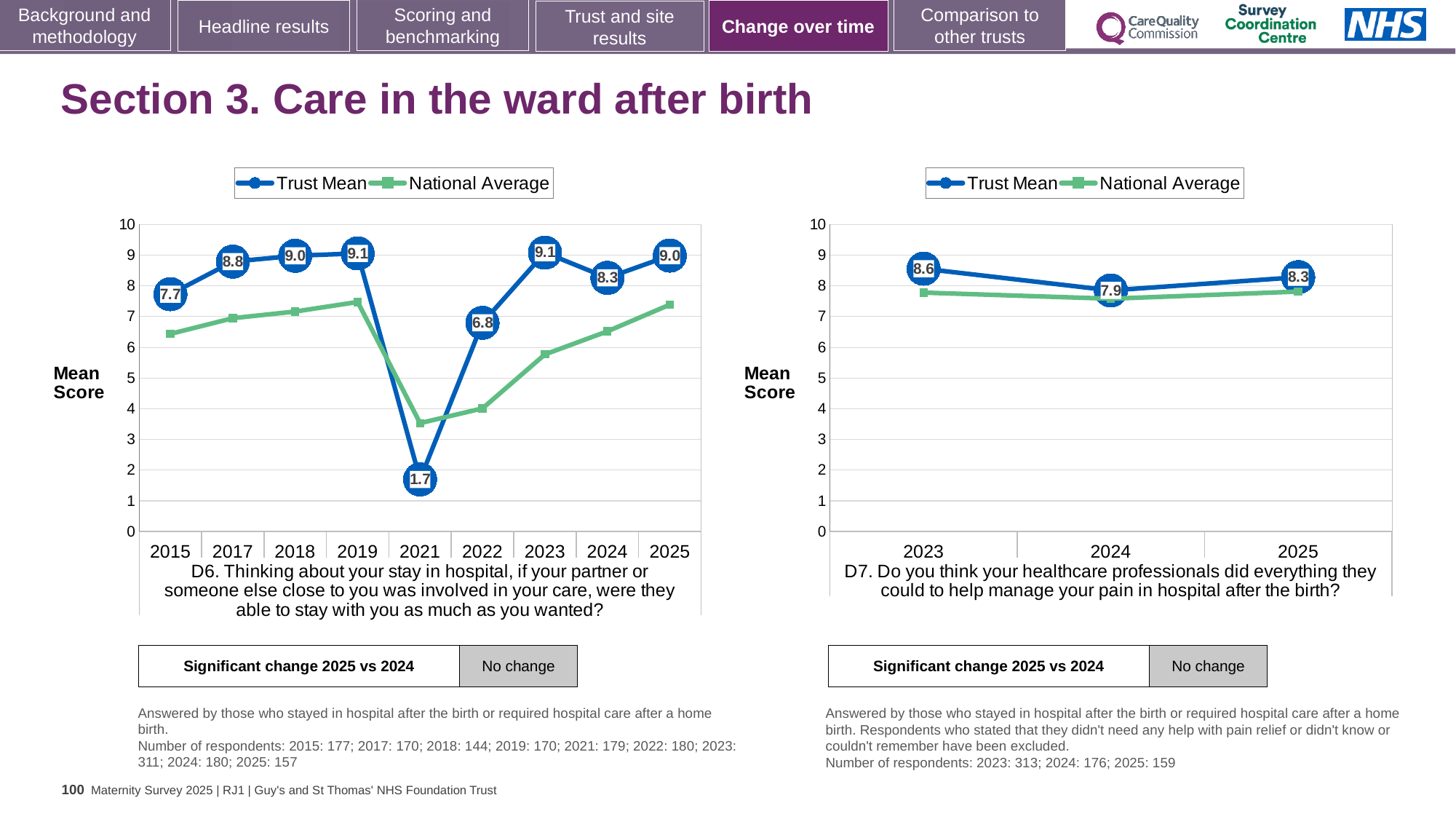
In the D7 chart on the right, which year has the highest Trust Mean score? 2023 In the D7 chart on the right, what is the difference between the Trust Mean scores for 2023 and 2025? 0.3 In the D6 chart on the left, what is the Trust Mean score for 2021? 1.7 In the D7 chart on the right, what is the Trust Mean score for 2024? 7.9 In the D6 chart on the left, is the National Average value for 2021 greater or less than 4? less In the D7 chart on the right, does the Trust Mean rise or fall from 2023 to 2024? fall How many years are plotted on the x axis of the D7 chart on the right? 3 In the D6 chart on the left, which is larger, the Trust Mean for 2015 or the Trust Mean for 2024? 2024 In the D6 chart on the left, what is the Trust Mean score for 2025? 9.0 How many series does the legend of the D6 chart on the left list? 2 In the D6 chart on the left, what is the difference between the Trust Mean scores for 2022 and 2021? 5.1 In the D6 chart on the left, which year has the lowest Trust Mean score? 2021